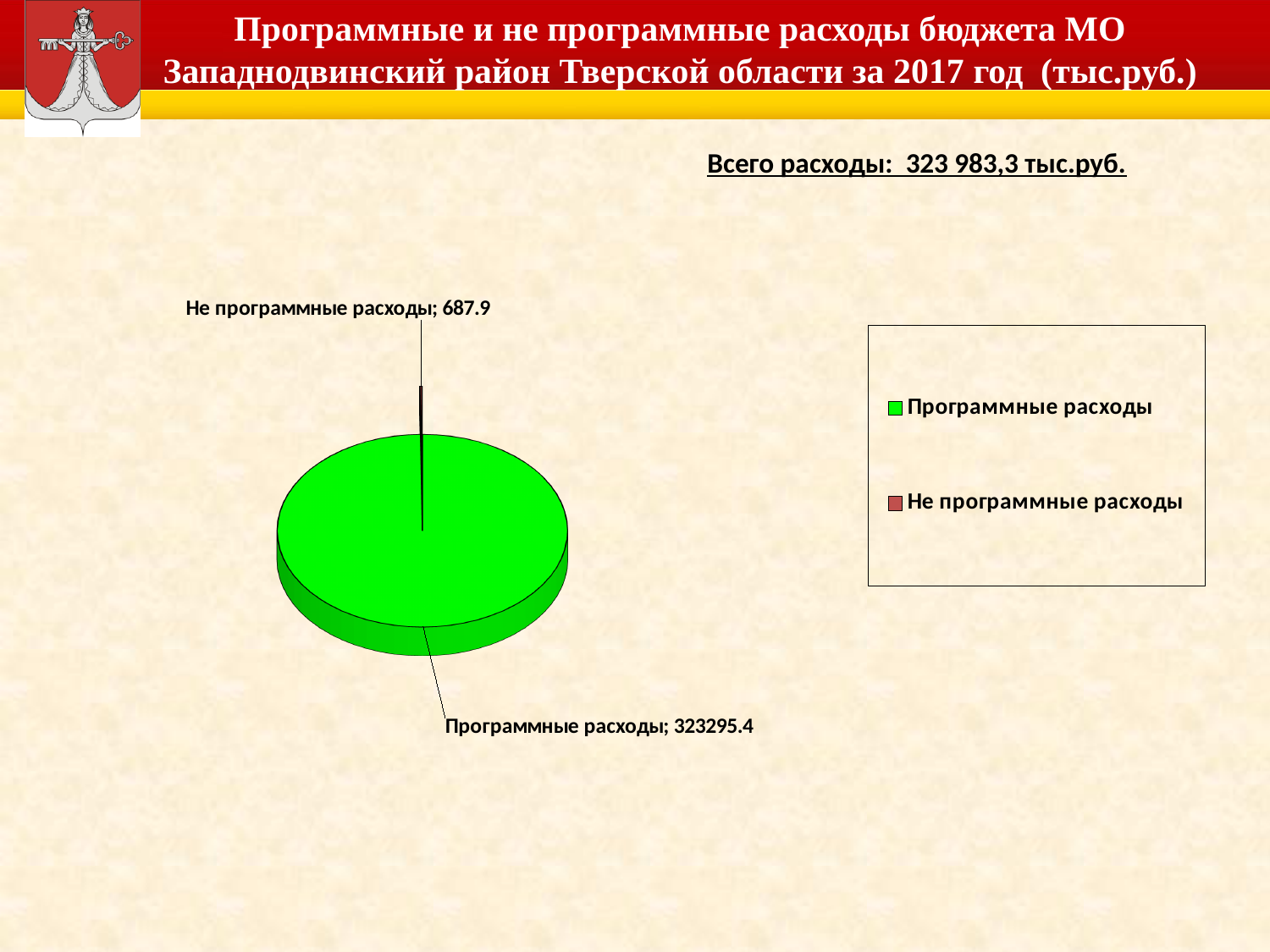
How many slices does the pie chart have? 2 Which is larger, Программные расходы or Не программные расходы? Программные расходы What is the difference between Программные расходы and Не программные расходы? 322607.5 How many entries does the legend list? 2 What colour is the slice for Программные расходы? green What total expenditure is stated on the slide? 323 983,3 тыс.руб. What is the value for Не программные расходы? 687.9 Which category has the largest slice of the pie? Программные расходы Which category has the smallest slice of the pie? Не программные расходы What type of chart is shown on the slide? pie chart What is the value for Программные расходы? 323295.4